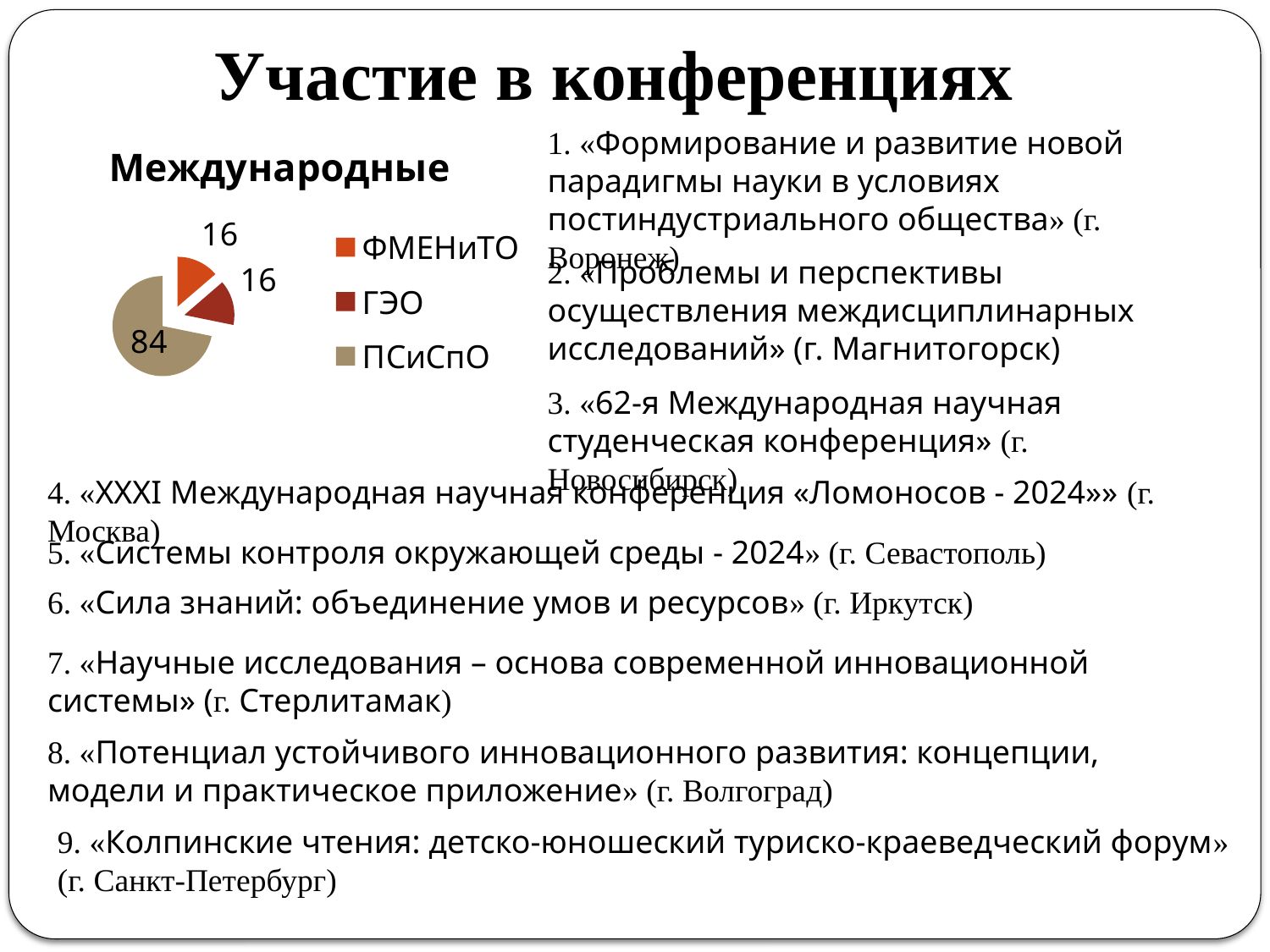
Which legend entry is shown in the tan/brown colour? ПСиСпО Which category has the largest slice in the pie chart? ПСиСпО What is the value for ФМЕНиТО in the pie chart? 16 What is the difference between the values for ПСиСпО and ГЭО? 68 Which is larger, the value for ПСиСпО or the value for ФМЕНиТО? ПСиСпО What is the total of all the values in the pie chart? 116 What is the value for ГЭО in the pie chart? 16 What kind of chart is shown on the slide? pie chart What is the value for ПСиСпО in the pie chart? 84 How many entries does the legend of the pie chart list? 3 What is the title of the pie chart? Международные How many slices does the pie chart have? 3